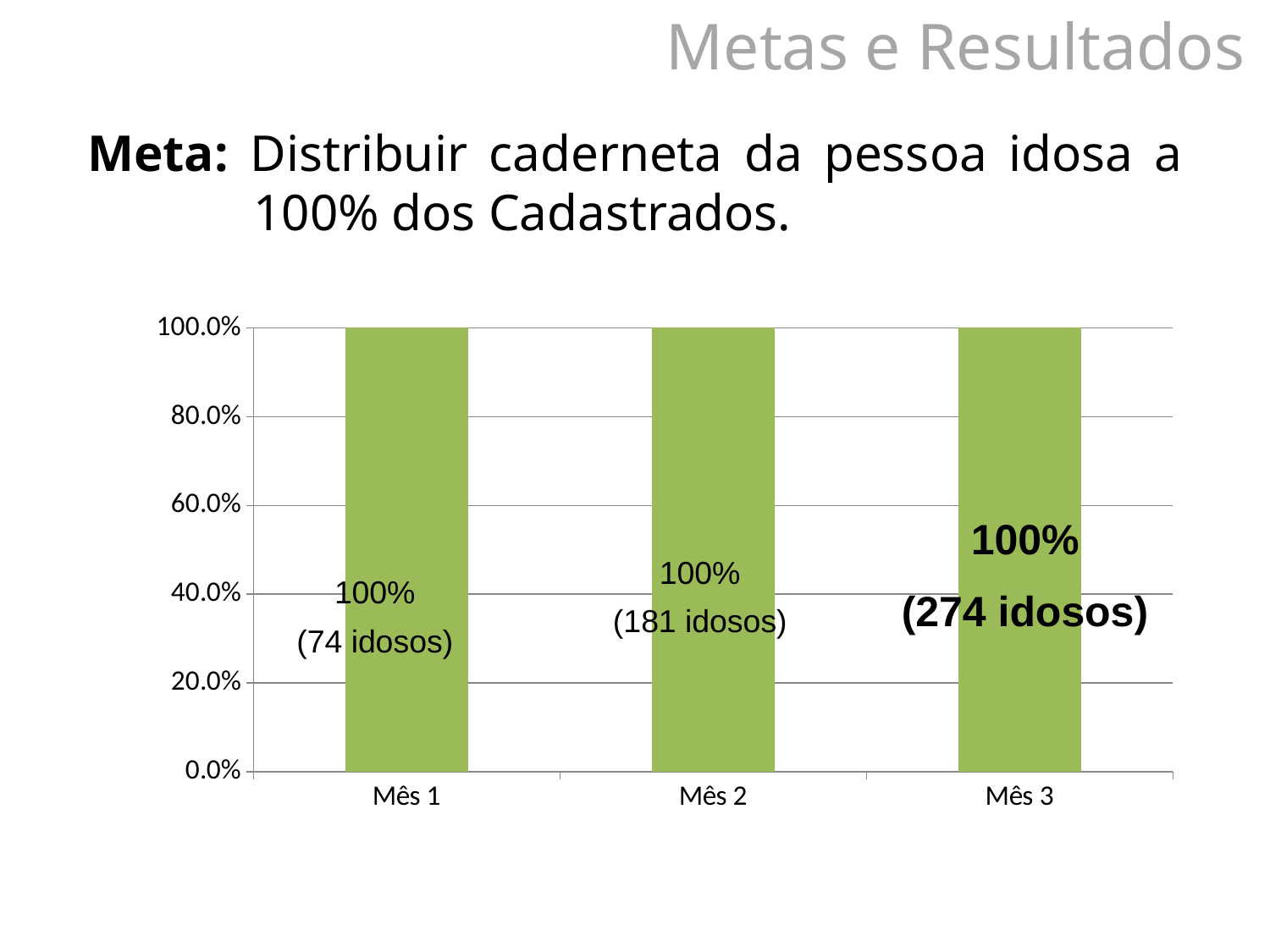
What is the difference in the number of idosos between Mês 2 and Mês 1? 107 What percentage is shown for Mês 1? 100% What is the difference in the number of idosos between Mês 3 and Mês 1? 200 Which month has the lowest number of idosos in its data label? Mês 1 Which month has the highest number of idosos in its data label? Mês 3 How many idosos are indicated in the data label for Mês 2? 181 idosos How many idosos are indicated in the data label for Mês 1? 74 idosos How many categories are shown on the x axis? 3 Do the percentage values rise, fall, or stay the same from Mês 1 to Mês 3? stay the same Is the value for Mês 2 greater or less than 80.0%? greater How many idosos are indicated in the data label for Mês 3? 274 idosos What kind of chart is shown on the slide? bar chart